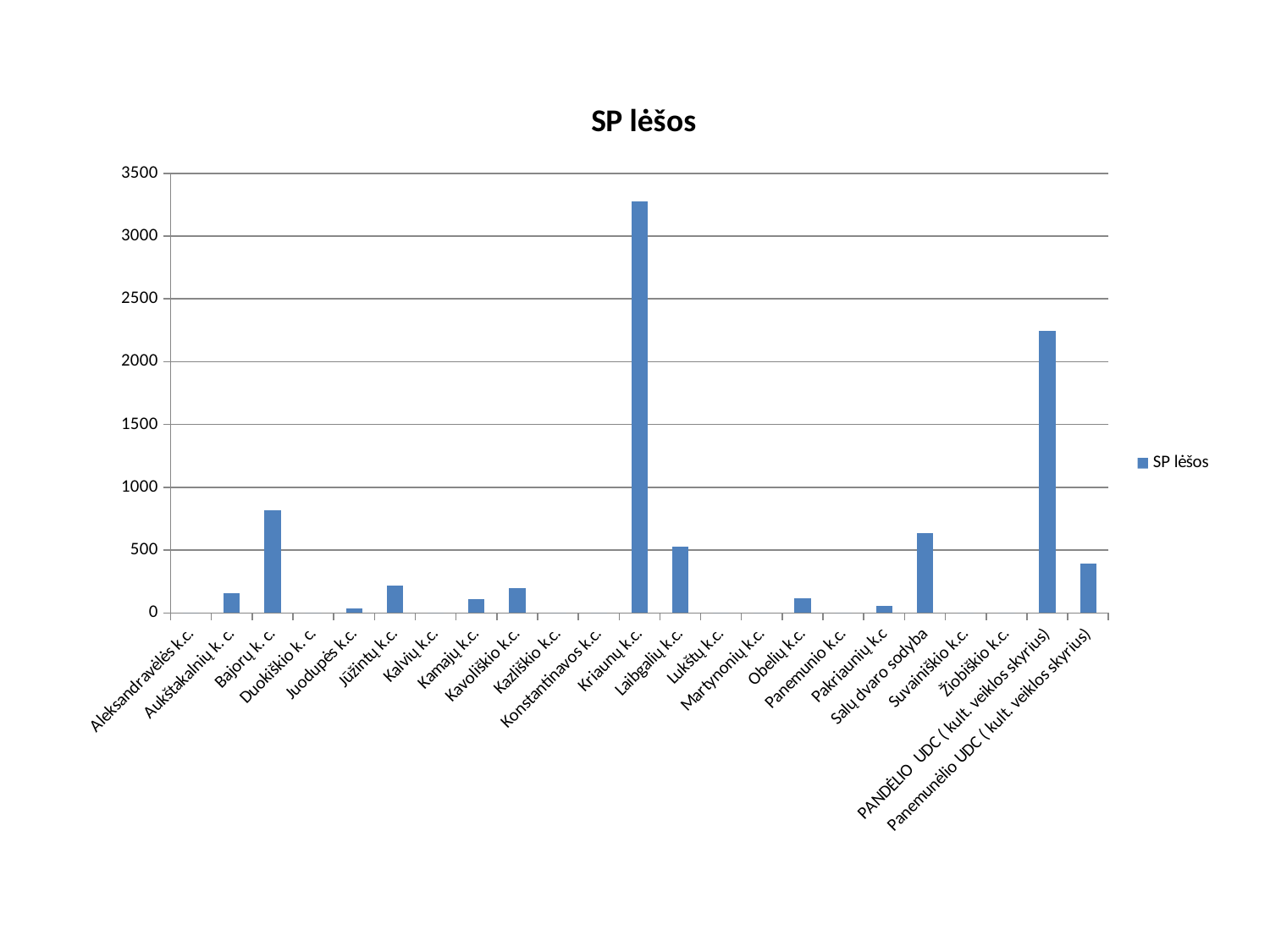
Which category has the highest value? Kriaunų k.c. What is the title of the chart? SP lėšos Which is larger, the value for Bajorų k. c. or the value for Laibgalių k.c.? Bajorų k. c. Is the value for Bajorų k. c. greater or less than 1000? less Is the value for PANDĖLIO UDC ( kult. veiklos skyrius) greater or less than 2000? greater Is the value for Salų dvaro sodyba greater or less than 500? greater How many categories are shown on the x axis? 23 What kind of chart is shown on the slide? bar chart How many series does the legend list? 1 Which is larger, the value for PANDĖLIO UDC ( kult. veiklos skyrius) or the value for Panemunėlio UDC ( kult. veiklos skyrius)? PANDĖLIO UDC ( kult. veiklos skyrius) What is the legend entry for the plotted series? SP lėšos